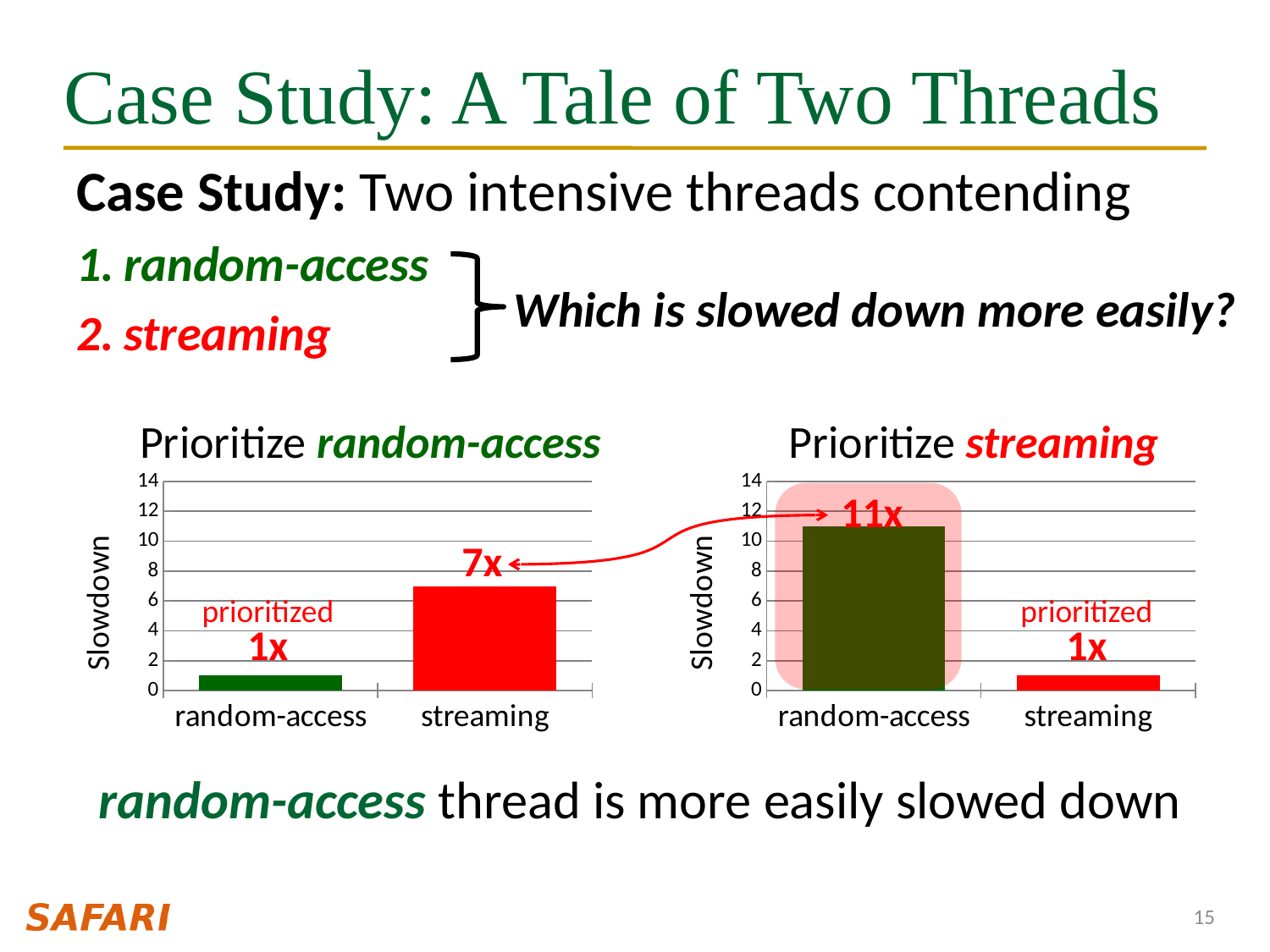
In the 'Prioritize random-access' chart, which thread has the lowest slowdown? random-access What is the y-axis label of the 'Prioritize random-access' chart? Slowdown In the 'Prioritize streaming' chart, what is the difference in slowdown between the random-access thread and the streaming thread? 10x In the 'Prioritize streaming' chart, what is the slowdown for the random-access thread? 11x In the 'Prioritize streaming' chart, is the slowdown for random-access greater or less than 10? greater What kind of chart is the 'Prioritize streaming' chart? bar chart In the 'Prioritize streaming' chart, which thread has the highest slowdown? random-access How many categories are shown on the x axis of the 'Prioritize random-access' chart? 2 In the 'Prioritize streaming' chart, what is the slowdown for the streaming thread? 1x In the 'Prioritize random-access' chart, what is the slowdown for the random-access thread? 1x Which is larger: the streaming slowdown in the 'Prioritize random-access' chart or the random-access slowdown in the 'Prioritize streaming' chart? random-access slowdown in the 'Prioritize streaming' chart In the 'Prioritize random-access' chart, what is the slowdown for the streaming thread? 7x